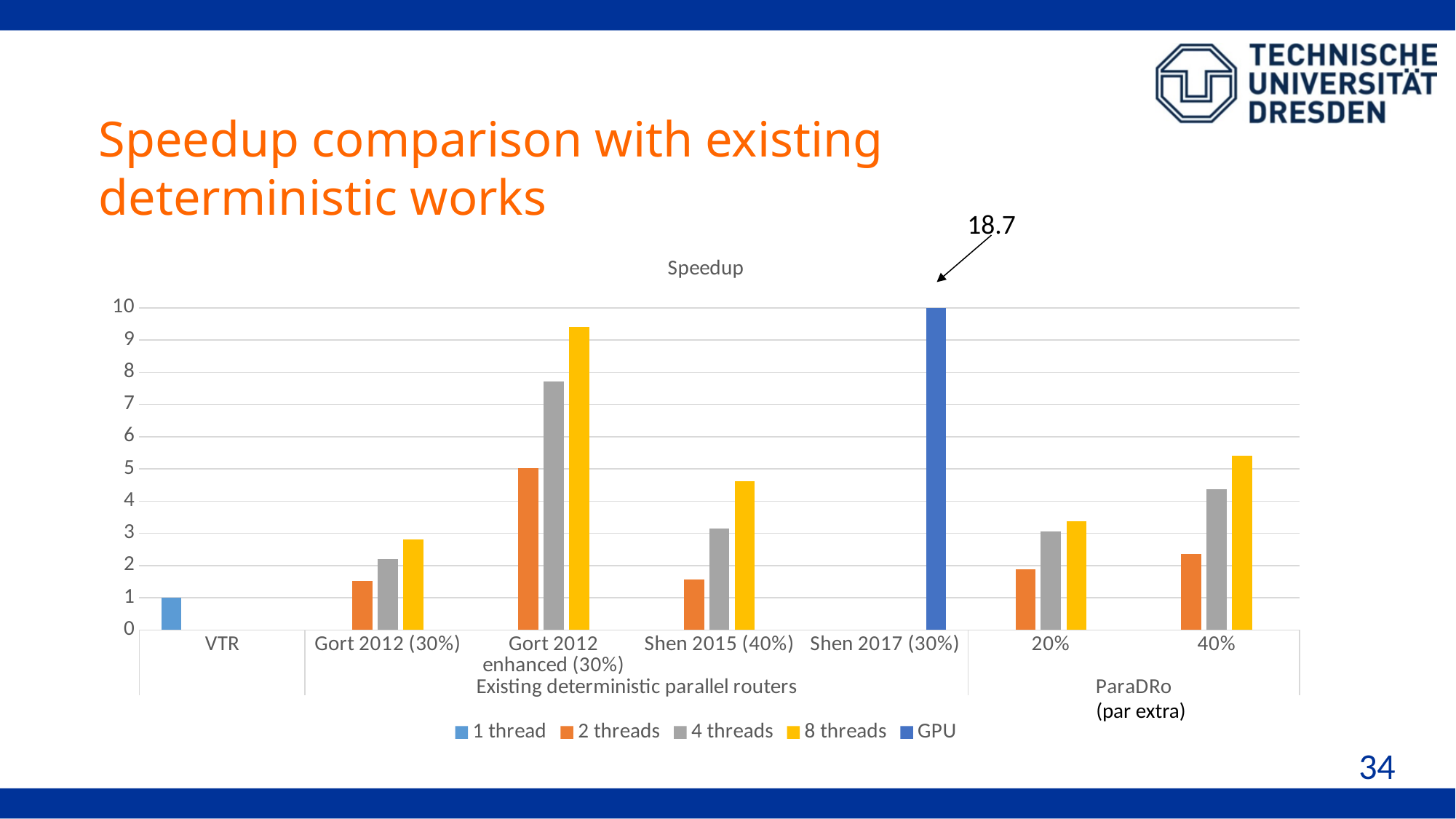
Which category has the highest 8 threads speedup? Gort 2012 enhanced (30%) What is the title of the chart? Speedup Is the 2 threads value for Gort 2012 (30%) greater or less than 2? less What kind of chart is shown on the slide? bar chart What is the GPU speedup for Shen 2017 (30%)? 18.7 Is the 8 threads value for the ParaDRo 40% category greater or less than 4? greater For the ParaDRo 20% category, do the values rise or fall going from 2 threads to 8 threads? rise How many series does the legend of the Speedup chart list? 5 How many categories are shown along the x axis of the Speedup chart? 7 What is the 1 thread speedup for VTR? 1 Is the 8 threads value for Gort 2012 enhanced (30%) greater or less than 8? greater Which has the larger 8 threads speedup: Gort 2012 enhanced (30%) or Shen 2015 (40%)? Gort 2012 enhanced (30%)